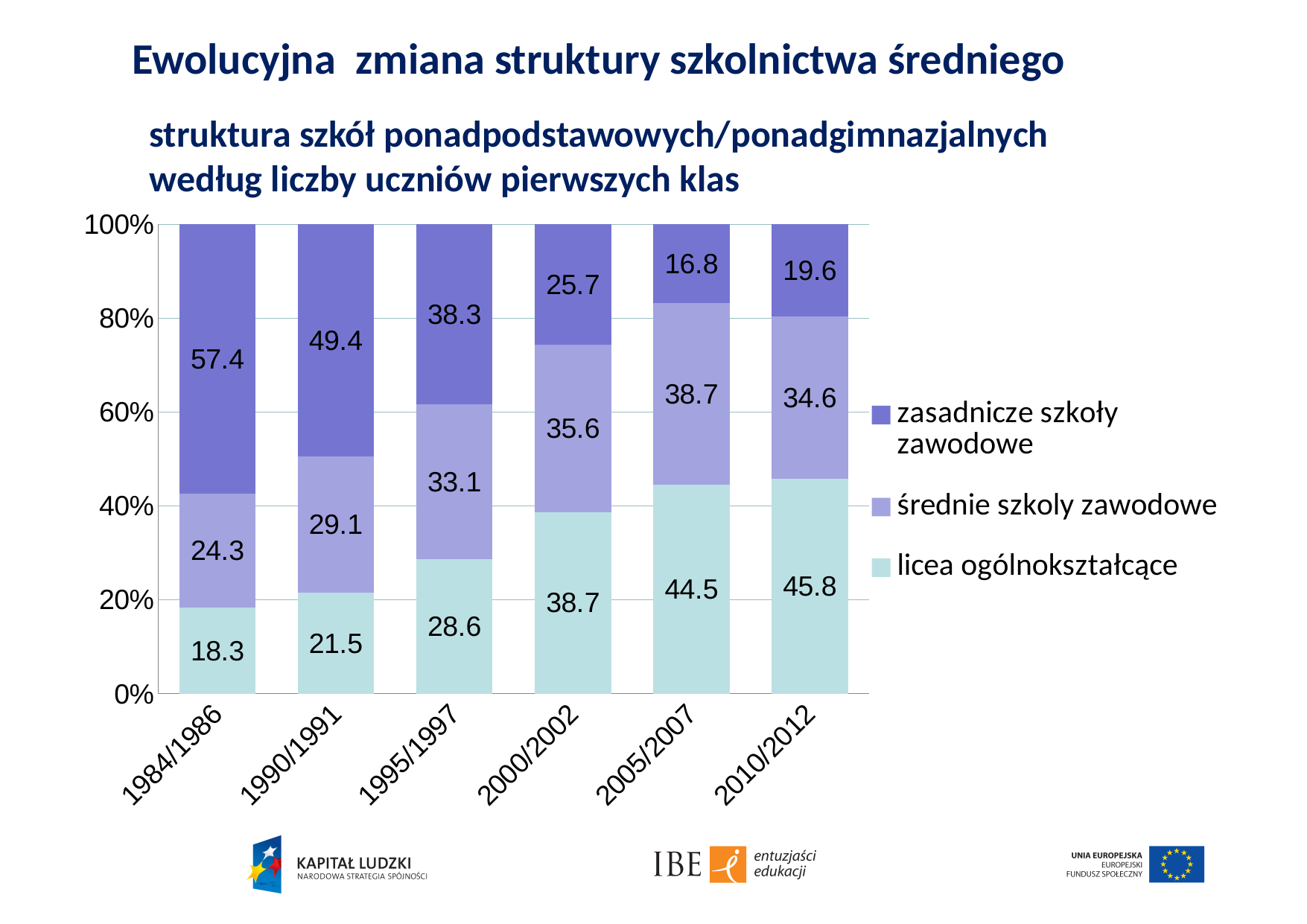
What is the value for licea ogólnokształcące in 1984/1986? 18.3 In which period is the value for licea ogólnokształcące lowest? 1984/1986 Which legend entry is shown in the lightest colour? licea ogólnokształcące How many series does the legend list? 3 What is the value for zasadnicze szkoły zawodowe in 2005/2007? 16.8 What kind of chart is shown on the slide? stacked bar chart Does the value for licea ogólnokształcące rise or fall from 1984/1986 to 2010/2012? rise In which period is the value for zasadnicze szkoły zawodowe highest? 1984/1986 How many periods are shown on the x axis? 6 What is the difference between the zasadnicze szkoły zawodowe values for 1984/1986 and 2010/2012? 37.8 What is the value for średnie szkoly zawodowe in 2000/2002? 35.6 Which is larger in 1995/1997: the value for licea ogólnokształcące or for zasadnicze szkoły zawodowe? zasadnicze szkoły zawodowe